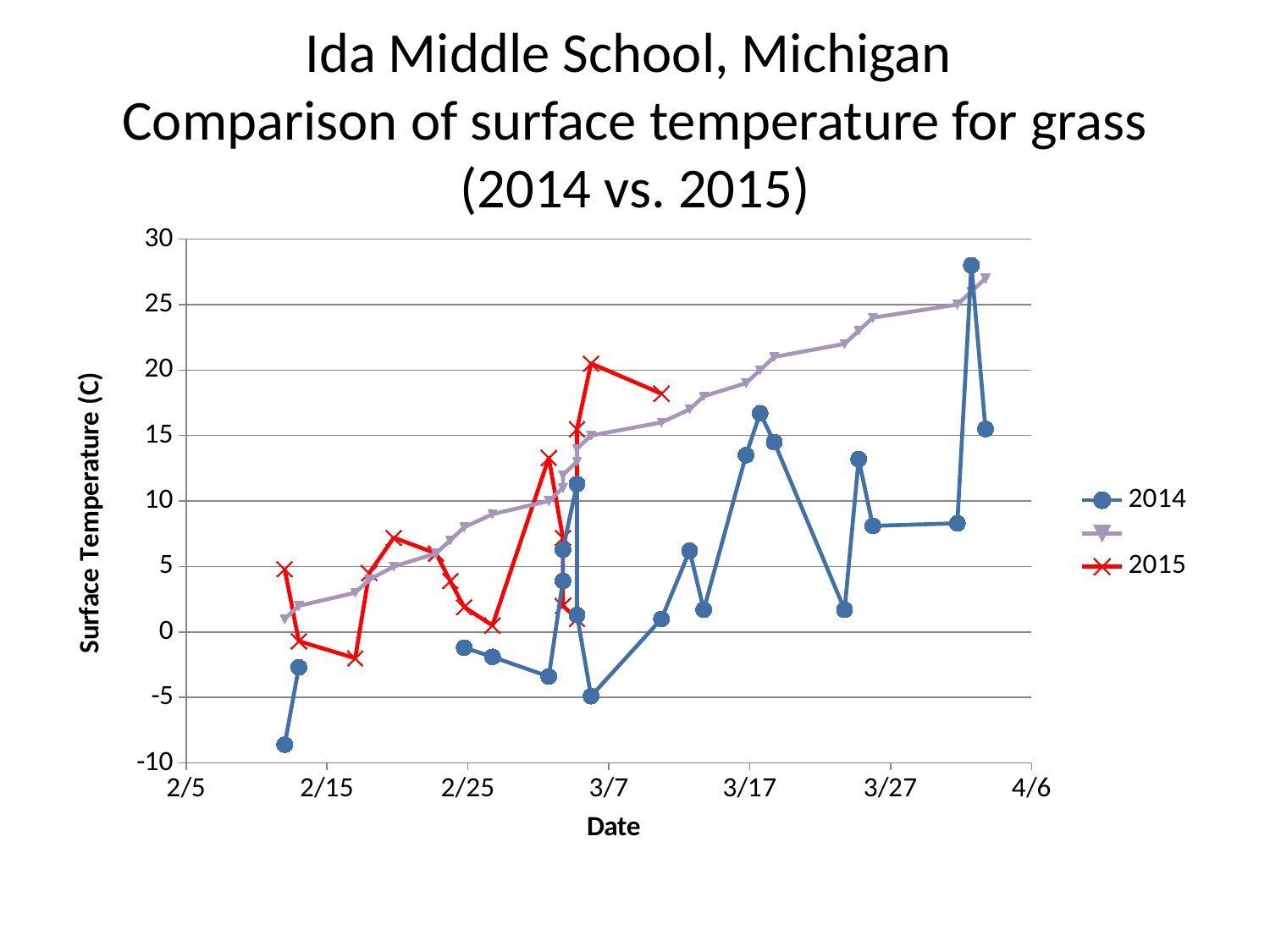
What is the title of the horizontal axis? Date Is the lowest value of the 2014 series greater or less than -5? less How many series does the legend list? 3 Is the last plotted value of the 2015 series (around 3/11) greater or less than 15? greater Does the purple triangle-marker series rise or fall as the date increases? rise Is the highest value of the 2014 series greater or less than 25? greater What is the title of the vertical axis? Surface Temperature (C) Which series reaches the highest surface temperature on the chart, 2014 or 2015? 2014 What kind of chart is shown on the slide? line chart Which series reaches the lowest surface temperature on the chart, 2014 or 2015? 2014